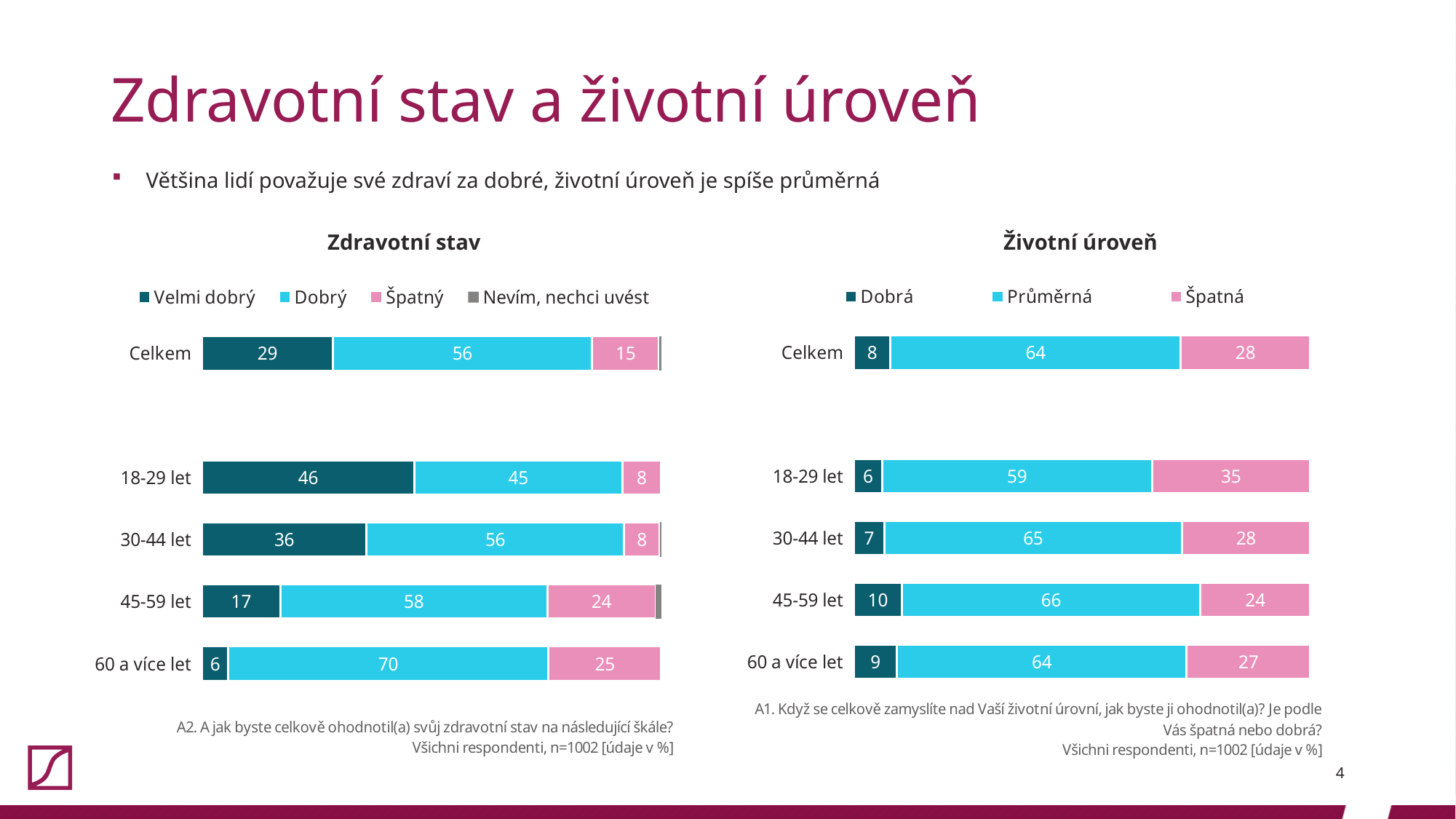
In the 'Životní úroveň' chart, what is the total of the stacked bar for 30-44 let? 100 In the 'Životní úroveň' chart, what is the 'Průměrná' value for Celkem? 64 What type of chart is the 'Životní úroveň' chart? Stacked bar chart How many series does the legend of the 'Zdravotní stav' chart list? 4 In the 'Zdravotní stav' chart, what is the difference between the 'Špatný' values for 60 a více let and 18-29 let? 17 In the 'Zdravotní stav' chart, which age group has the highest 'Velmi dobrý' value? 18-29 let In the 'Zdravotní stav' chart, what is the 'Dobrý' value for 60 a více let? 70 In the 'Zdravotní stav' chart, what is the 'Velmi dobrý' value for 18-29 let? 46 In the 'Životní úroveň' chart, which age group has the lowest 'Dobrá' value? 18-29 let How many categories (rows) are shown in the 'Životní úroveň' chart? 5 In the 'Životní úroveň' chart, what is the 'Špatná' value for 18-29 let? 35 In the 'Životní úroveň' chart, which is larger: the 'Špatná' value for 18-29 let or for 45-59 let? 18-29 let